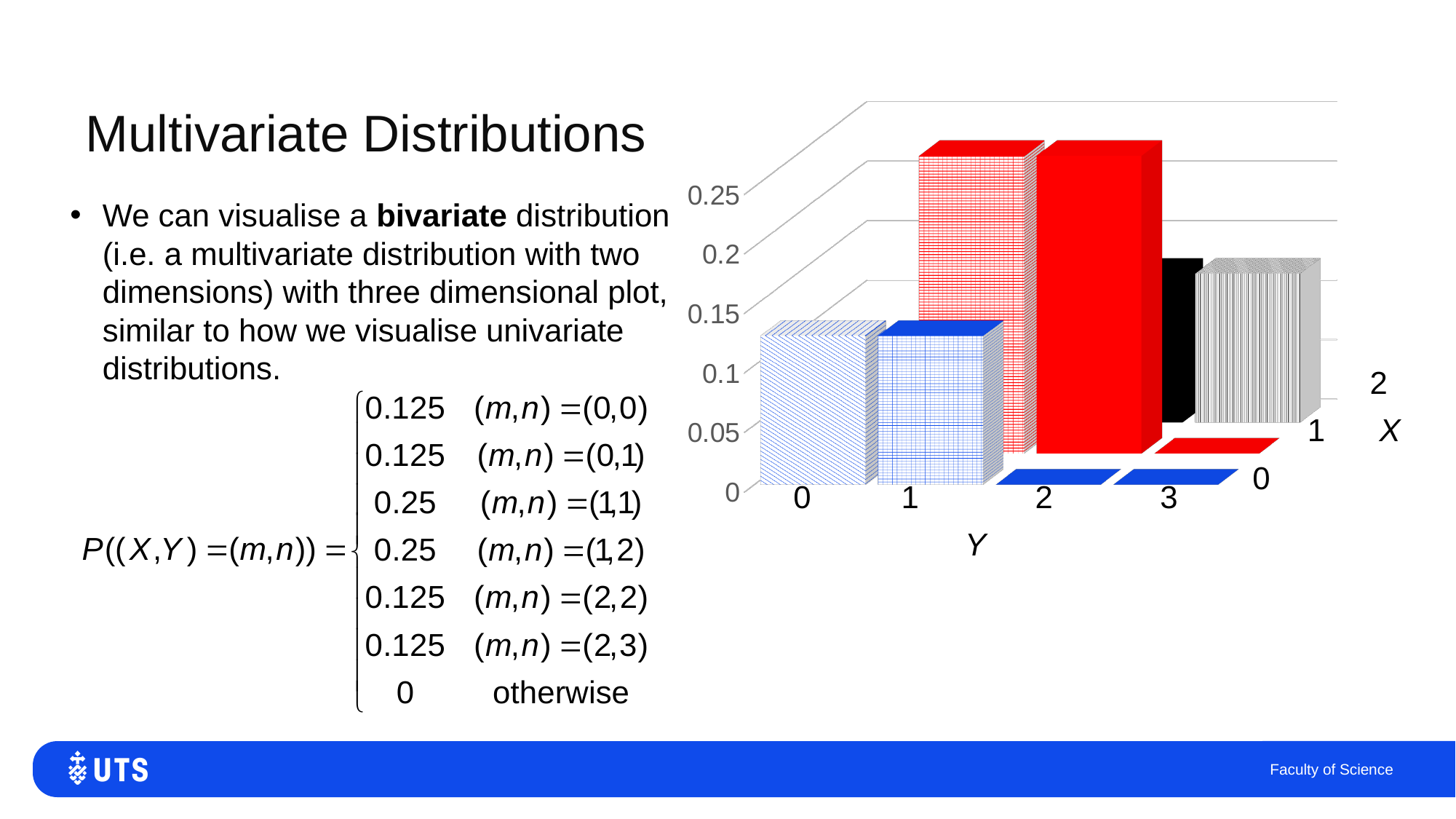
What is the highest tick value shown on the vertical axis of the chart? 0.25 Is the value of the bar at X = 1, Y = 2 greater or less than 0.2? greater Which X value has the tallest bars in the chart? 1 Which is larger: the bar at X = 1, Y = 1 or the bar at X = 0, Y = 1? X = 1, Y = 1 Is the value of the bar at X = 0, Y = 0 greater or less than 0.2? less Is the value of the bar at X = 2, Y = 3 greater or less than 0.2? less How many categories are shown along the Y axis of the chart? 4 How many categories are shown along the X axis of the chart? 3 What colour are the bars for X = 1 in the chart? red What kind of chart is shown on the slide? bar chart